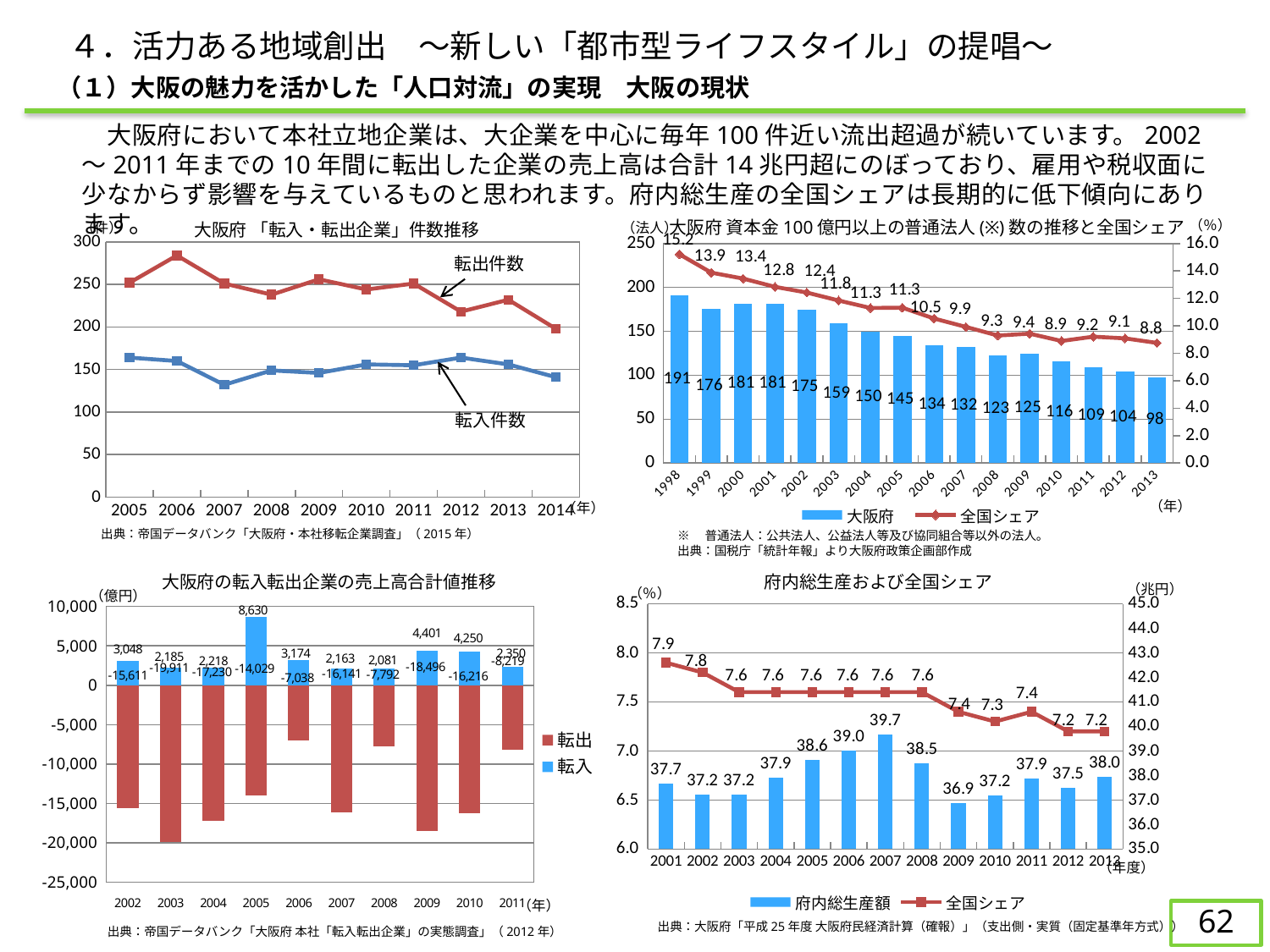
In the chart titled 大阪府 資本金100億円以上の普通法人(※)数の推移と全国シェア, what is the 全国シェア value for 2013? 8.8 In the chart titled 大阪府の転入転出企業の売上高合計値推移, what is the 転入 value for 2005? 8,630 In the chart titled 大阪府 資本金100億円以上の普通法人(※)数の推移と全国シェア, what is the difference between the 大阪府 values for 1998 and 2013? 93 In the chart titled 大阪府「転入・転出企業」件数推移, how many series does the chart show? 2 In the chart titled 大阪府の転入転出企業の売上高合計値推移, what is the 転出 value for 2003? -19,911 In the chart titled 大阪府「転入・転出企業」件数推移, is the 転出件数 value for 2006 greater or less than 250? greater In the chart titled 大阪府 資本金100億円以上の普通法人(※)数の推移と全国シェア, what is the 大阪府 value for 1998? 191 In the chart titled 府内総生産および全国シェア, what is the 府内総生産額 value for 2007? 39.7 In the chart titled 大阪府 資本金100億円以上の普通法人(※)数の推移と全国シェア, which year has the lowest 大阪府 bar? 2013 In the chart titled 府内総生産および全国シェア, which year has the lowest 府内総生産額 bar? 2009 In the chart titled 府内総生産および全国シェア, does the 全国シェア line generally rise or fall from 2001 to 2013? fall In the chart titled 大阪府の転入転出企業の売上高合計値推移, which year has the highest 転入 value? 2005